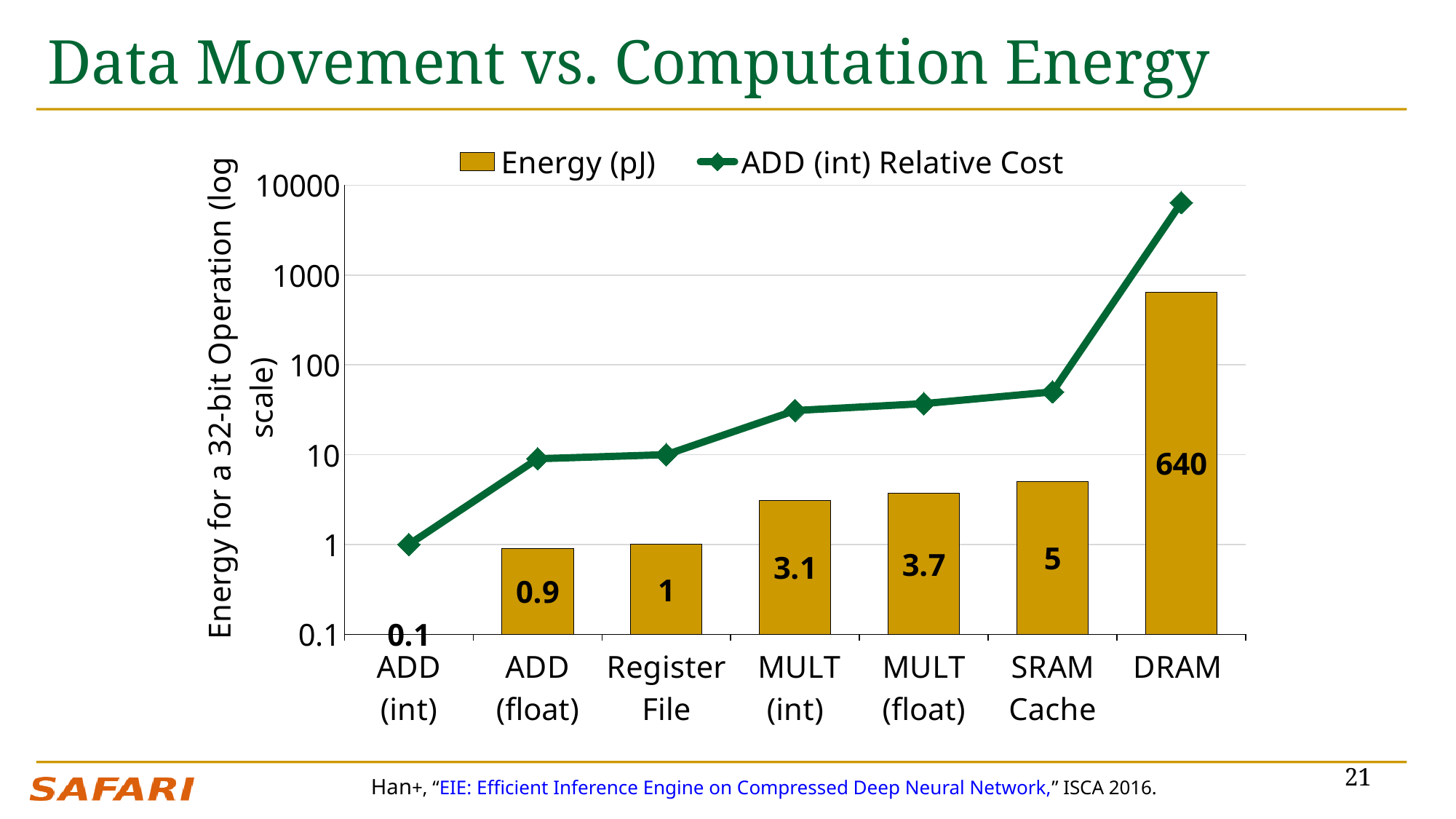
Which category has the highest Energy (pJ) value? DRAM Which has a higher Energy (pJ) value, Register File or ADD (float)? Register File How many categories are shown on the x axis? 7 Which category has the lowest Energy (pJ) value? ADD (int) What is the Energy (pJ) value for ADD (int)? 0.1 What is the Energy (pJ) value for DRAM? 640 Is the ADD (int) Relative Cost value for DRAM greater or less than 1000? greater How many series does the legend list? 2 Do the Energy (pJ) values rise or fall from left to right along the x axis? rise Is the ADD (int) Relative Cost value for SRAM Cache greater or less than 100? less What is the difference in Energy (pJ) between SRAM Cache and MULT (int)? 1.9 What is the Energy (pJ) value for MULT (float)? 3.7